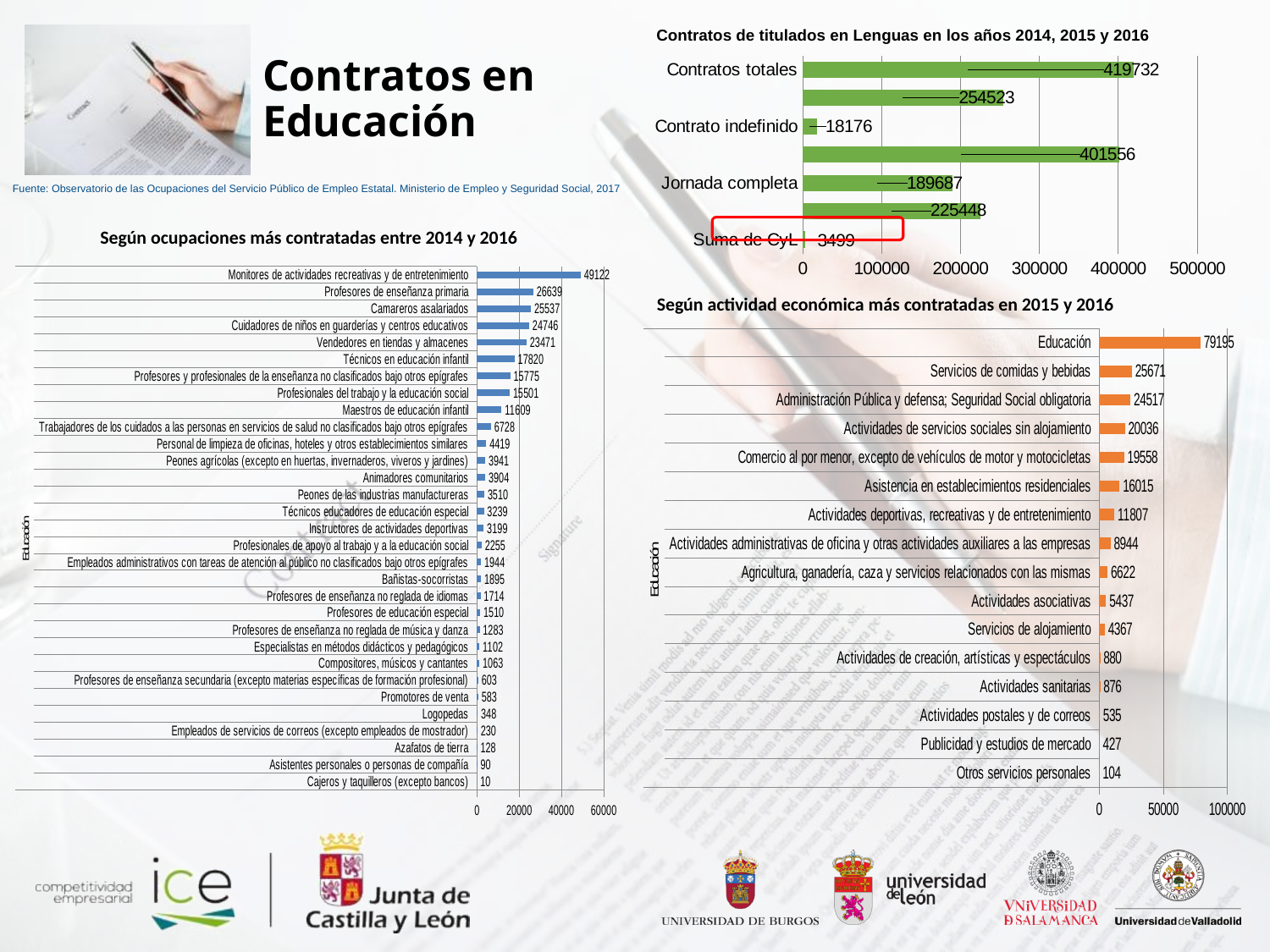
In the chart 'Según ocupaciones más contratadas entre 2014 y 2016', what is the value for Logopedas? 348 In the chart 'Contratos de titulados en Lenguas en los años 2014, 2015 y 2016', what is the value for Suma de CyL? 3499 In the chart 'Según ocupaciones más contratadas entre 2014 y 2016', which is larger: Camareros asalariados or Vendedores en tiendas y almacenes? Camareros asalariados In the chart 'Según ocupaciones más contratadas entre 2014 y 2016', what is the value for Monitores de actividades recreativas y de entretenimiento? 49122 In the chart 'Según actividad económica más contratadas en 2015 y 2016', what colour are the bars? Orange In the chart 'Según actividad económica más contratadas en 2015 y 2016', what is the difference between Servicios de comidas y bebidas and Administración Pública y defensa; Seguridad Social obligatoria? 1154 In the chart 'Según actividad económica más contratadas en 2015 y 2016', what is the value for Educación? 79195 How many categories are shown in the chart 'Según actividad económica más contratadas en 2015 y 2016'? 16 What type of chart is 'Según ocupaciones más contratadas entre 2014 y 2016'? Bar chart In the chart 'Contratos de titulados en Lenguas en los años 2014, 2015 y 2016', what is the largest value shown for Contratos totales? 419732 In the chart 'Según actividad económica más contratadas en 2015 y 2016', which activity has the lowest value? Otros servicios personales In the chart 'Según ocupaciones más contratadas entre 2014 y 2016', which occupation has the lowest value? Cajeros y taquilleros (excepto bancos)